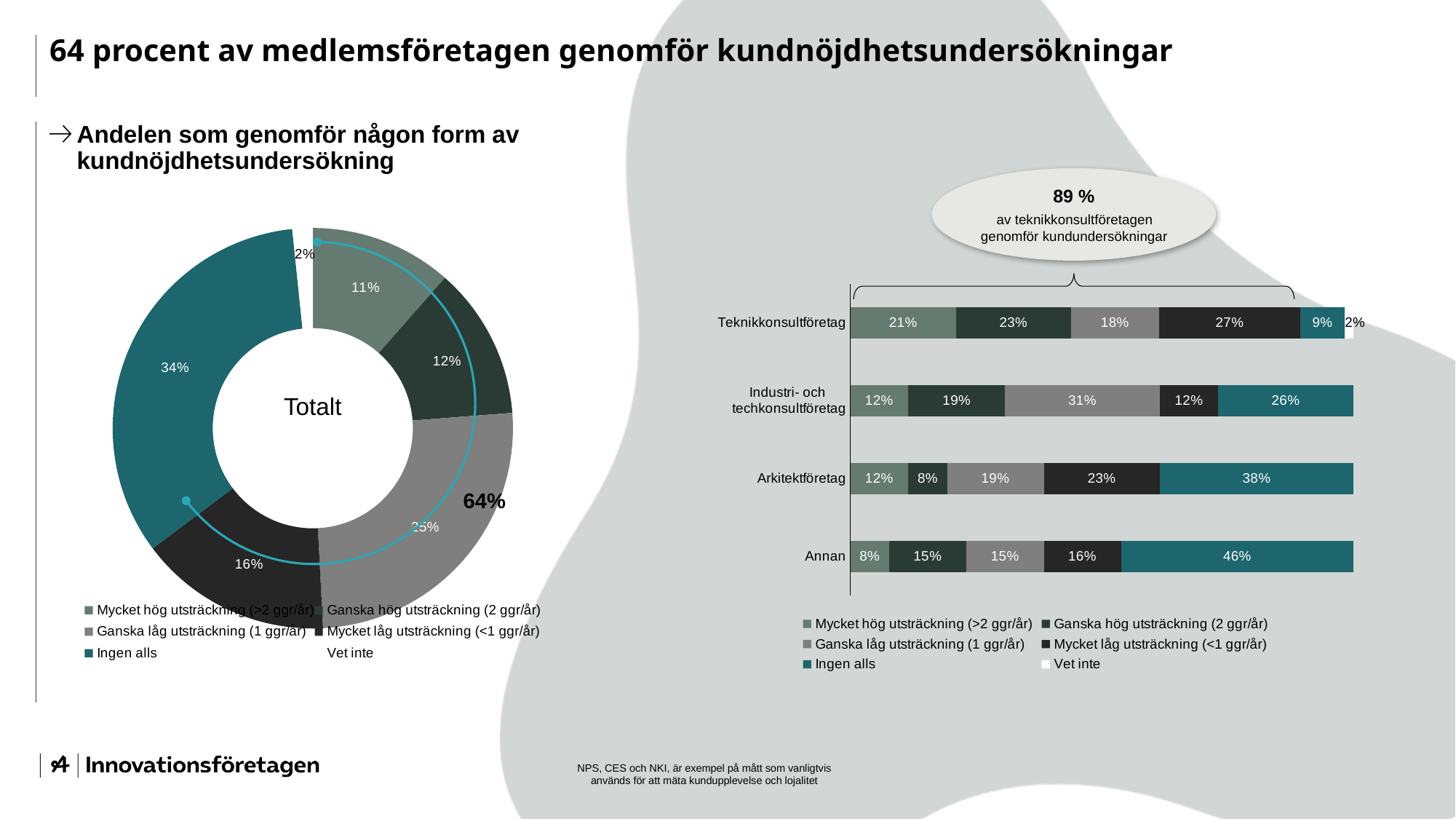
In the donut chart on the left, what is the difference between the 'Ganska låg utsträckning (1 ggr/år)' share and the 'Mycket låg utsträckning (<1 ggr/år)' share? 9% In the stacked bar chart on the right, what is the 'Ganska låg utsträckning (1 ggr/år)' value for Industri- och techkonsultföretag? 31% How many categories are shown on the vertical axis of the stacked bar chart on the right? 4 In the donut chart on the left, which category has the largest share? Ingen alls What kind of chart is the chart on the left of the slide? Donut (pie) chart In the stacked bar chart on the right, what is the 'Ingen alls' value for Annan? 46% In the donut chart on the left, what share is labelled for 'Ingen alls'? 34% In the stacked bar chart on the right, is the 'Ingen alls' value larger for Arkitektföretag or for Industri- och techkonsultföretag? Arkitektföretag In the stacked bar chart on the right, which category has the highest 'Mycket hög utsträckning (>2 ggr/år)' value? Teknikkonsultföretag In the donut chart on the left, which category has the smallest share? Vet inte How many series does the legend of the stacked bar chart on the right list? 6 What kind of chart is the chart on the right of the slide? Stacked bar chart